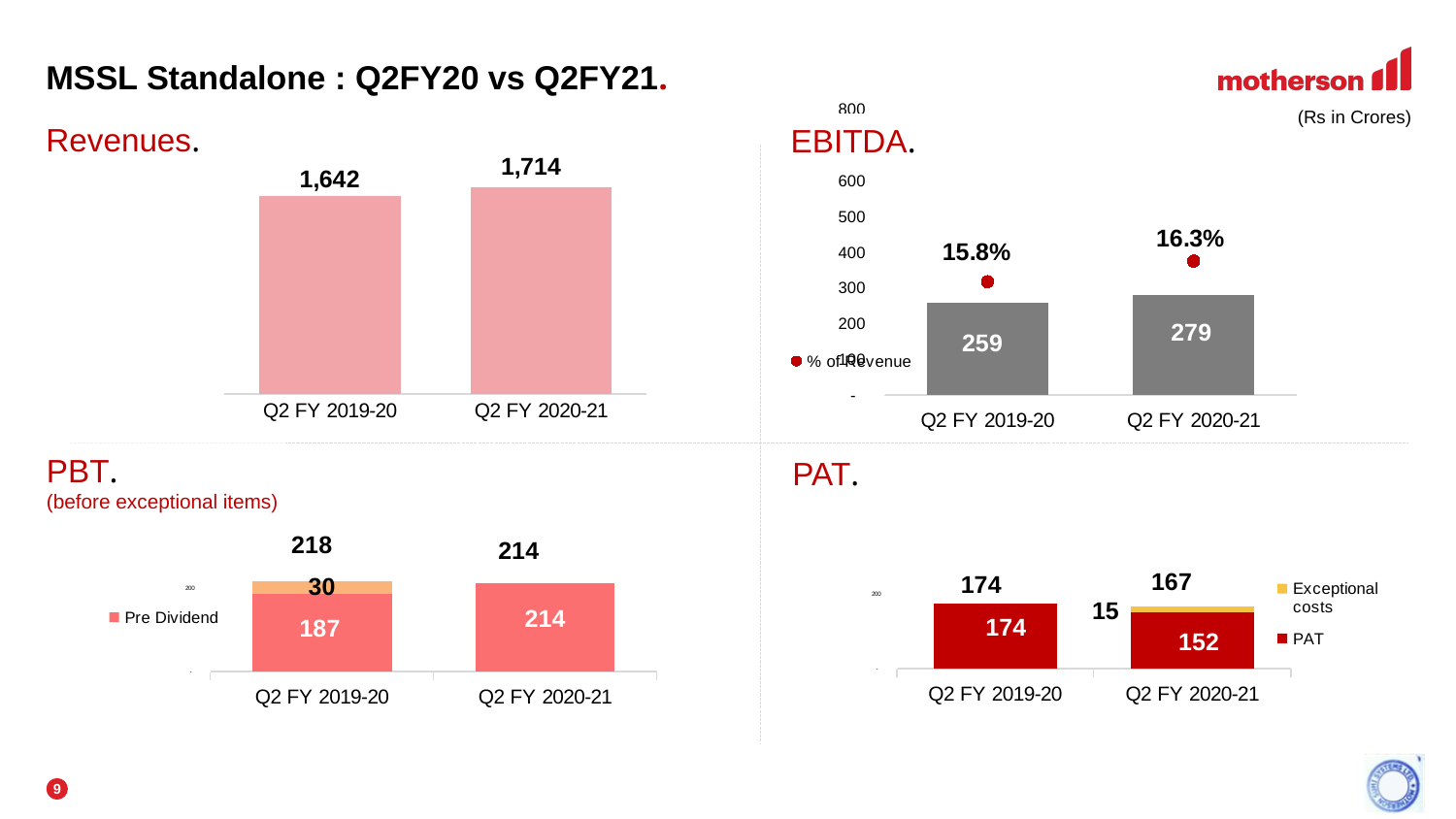
In the PAT chart, how many series does the legend list? 2 In the Revenues chart, what is the value for Q2 FY 2020-21? 1,714 In the EBITDA chart, is the bar for Q2 FY 2020-21 greater or less than 400? less In the PAT chart, what is the Exceptional costs value for Q2 FY 2020-21? 15 In the EBITDA chart, what is the % of Revenue for Q2 FY 2020-21? 16.3% In the PBT chart, what is the Pre Dividend value for Q2 FY 2019-20? 187 In the PBT chart, what is the total shown above the Q2 FY 2019-20 bar? 218 In the EBITDA chart, what is the difference in EBITDA between Q2 FY 2020-21 and Q2 FY 2019-20? 20 How many charts are shown on the slide? 4 In the EBITDA chart, what is the EBITDA value for Q2 FY 2019-20? 259 In the Revenues chart, what is the difference between Q2 FY 2020-21 and Q2 FY 2019-20? 72 In the Revenues chart, which period has the higher value? Q2 FY 2020-21